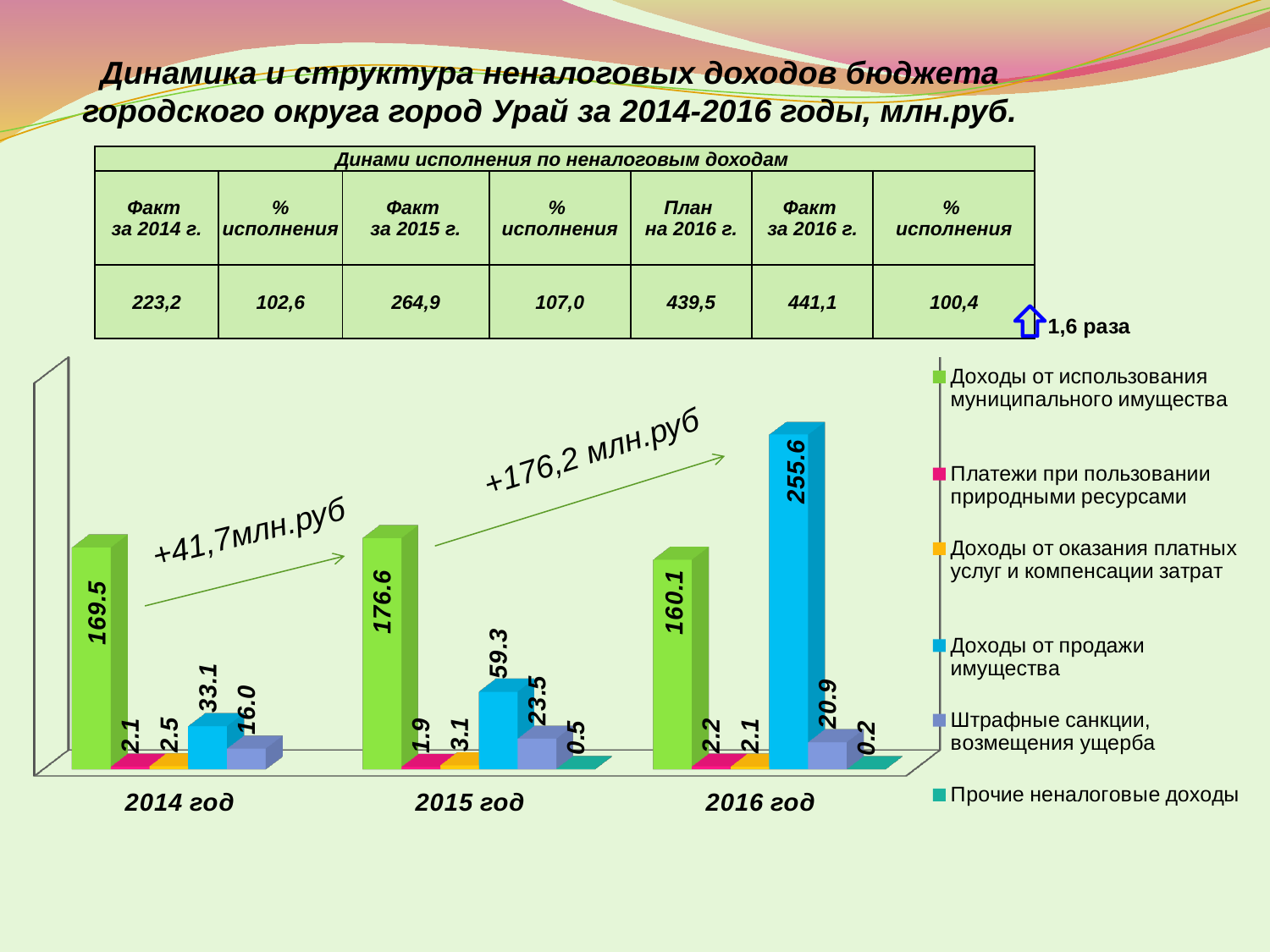
Which is larger in 2016 год: 'Доходы от использования муниципального имущества' or 'Доходы от продажи имущества'? Доходы от продажи имущества What kind of chart is shown on the slide? bar chart What is the value for 'Доходы от использования муниципального имущества' in 2014 год? 169.5 What is the value for 'Штрафные санкции, возмещения ущерба' in 2015 год? 23.5 What is the difference between the 'Доходы от продажи имущества' values for 2016 год and 2015 год? 196.3 Which year has the highest value for 'Доходы от продажи имущества'? 2016 год Does the value for 'Доходы от продажи имущества' rise or fall from 2014 год to 2016 год? rise What is the value for 'Доходы от продажи имущества' in 2016 год? 255.6 What is the value for 'Прочие неналоговые доходы' in 2016 год? 0.2 How many year categories are shown on the x axis of the chart? 3 Which year has the lowest value for 'Доходы от использования муниципального имущества'? 2016 год How many series does the chart legend list? 6